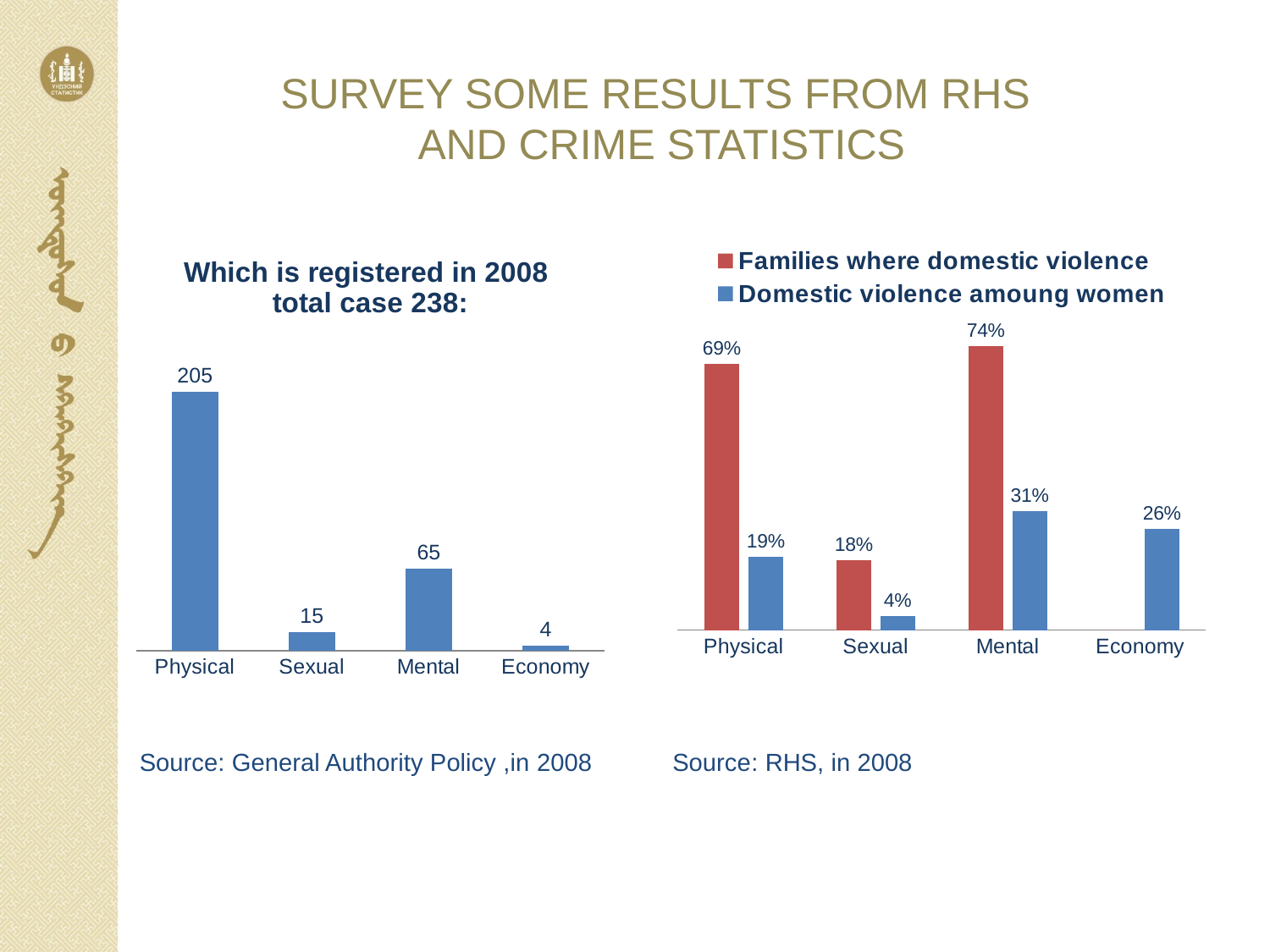
In the left chart titled 'Which is registered in 2008 total case 238:', what is the difference between the values for Physical and Mental? 140 What kind of chart is the left chart titled 'Which is registered in 2008 total case 238:'? bar chart In the left chart titled 'Which is registered in 2008 total case 238:', how many categories are shown on the x axis? 4 How many series does the legend of the right chart list? 2 In the right chart, what colour are the bars for the 'Families where domestic violence' series? red In the left chart titled 'Which is registered in 2008 total case 238:', what is the value for Physical? 205 In the right chart, what is the difference between the 'Families where domestic violence' and 'Domestic violence amoung women' values for Physical? 50% In the left chart titled 'Which is registered in 2008 total case 238:', which category has the lowest value? Economy In the right chart, which is larger for Sexual: 'Families where domestic violence' or 'Domestic violence amoung women'? Families where domestic violence In the right chart, what is the value for Economy in the 'Domestic violence amoung women' series? 26% In the right chart, what is the value for Mental in the 'Families where domestic violence' series? 74% In the right chart, which category has the highest value in the 'Domestic violence amoung women' series? Mental